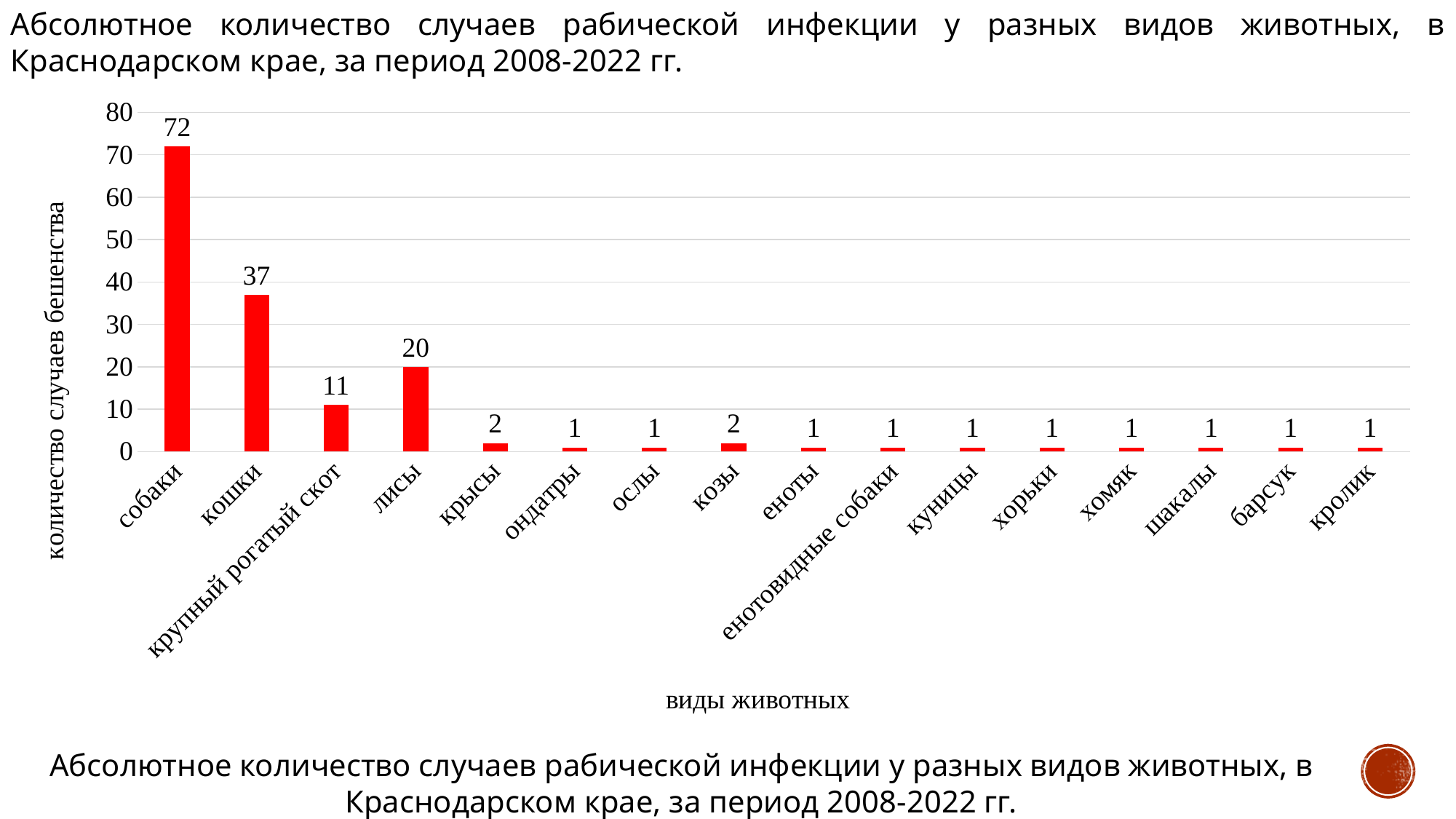
What is the value for лисы? 20 What is the difference between the values for лисы and крупный рогатый скот? 9 Which is larger, the value for кошки or the value for лисы? кошки Which animal category has the highest number of cases? собаки What is the value for крупный рогатый скот? 11 What is the difference between the values for собаки and кошки? 35 What type of chart is shown on the slide? bar chart How many animal categories are shown on the x axis? 16 What is the value for козы? 2 What is the label of the y axis? количество случаев бешенства What is the value for кошки? 37 How many cases of rabies are shown for собаки? 72